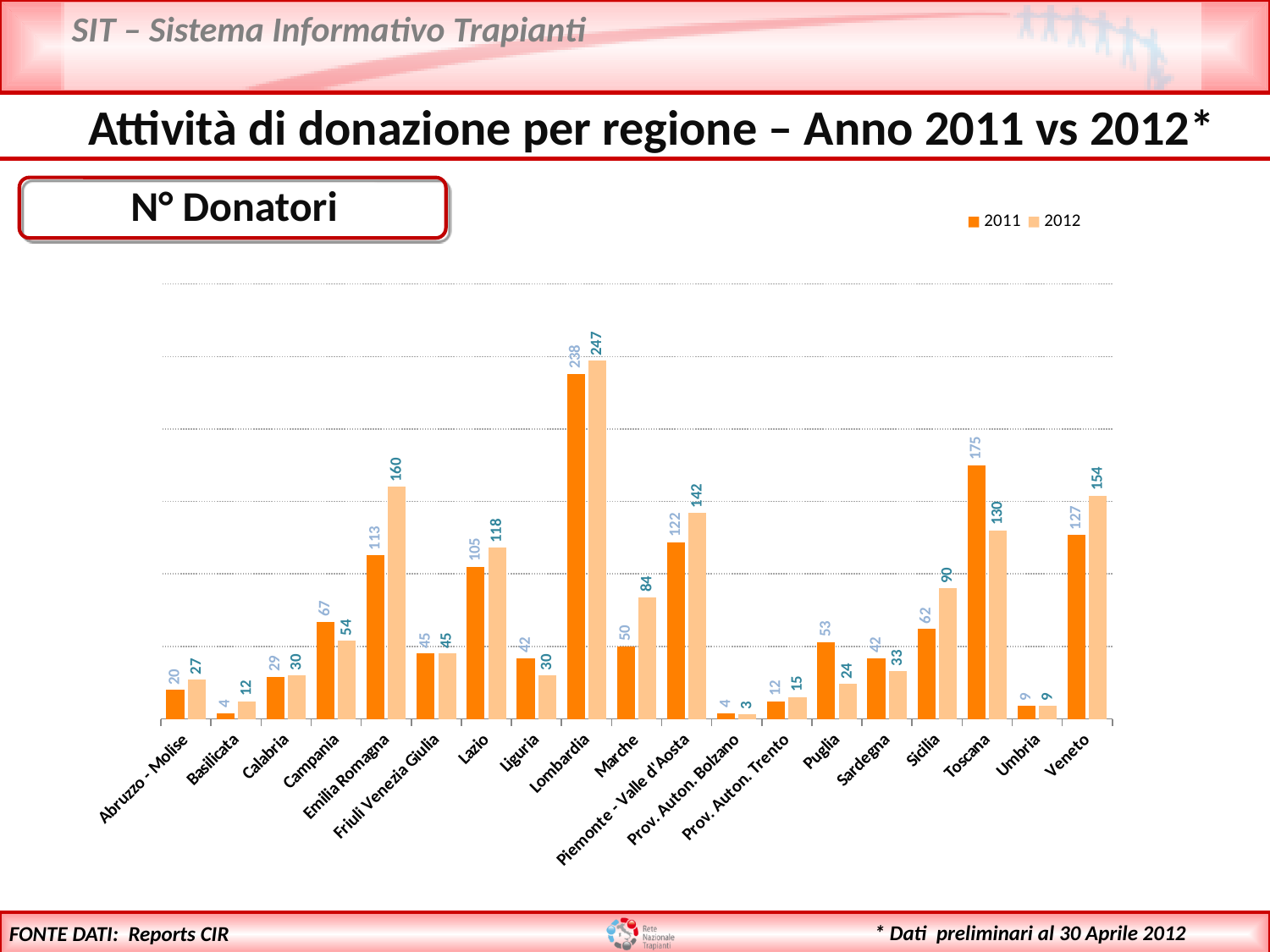
How many series does the legend list? 2 What is the value for Lombardia in 2012? 247 Which is larger for Toscana, the 2011 value or the 2012 value? 2011 How many regions are shown on the x axis? 19 What is the value for Emilia Romagna in 2012? 160 Which region has the highest value in 2011? Lombardia What is the title shown in the box above the chart? N° Donatori Which region has the lowest value in 2012? Prov. Auton. Bolzano What kind of chart is shown? Bar chart What is the value for Toscana in 2011? 175 Which is larger for Sicilia, the 2011 value or the 2012 value? 2012 What is the difference between the 2012 and 2011 values for Emilia Romagna? 47